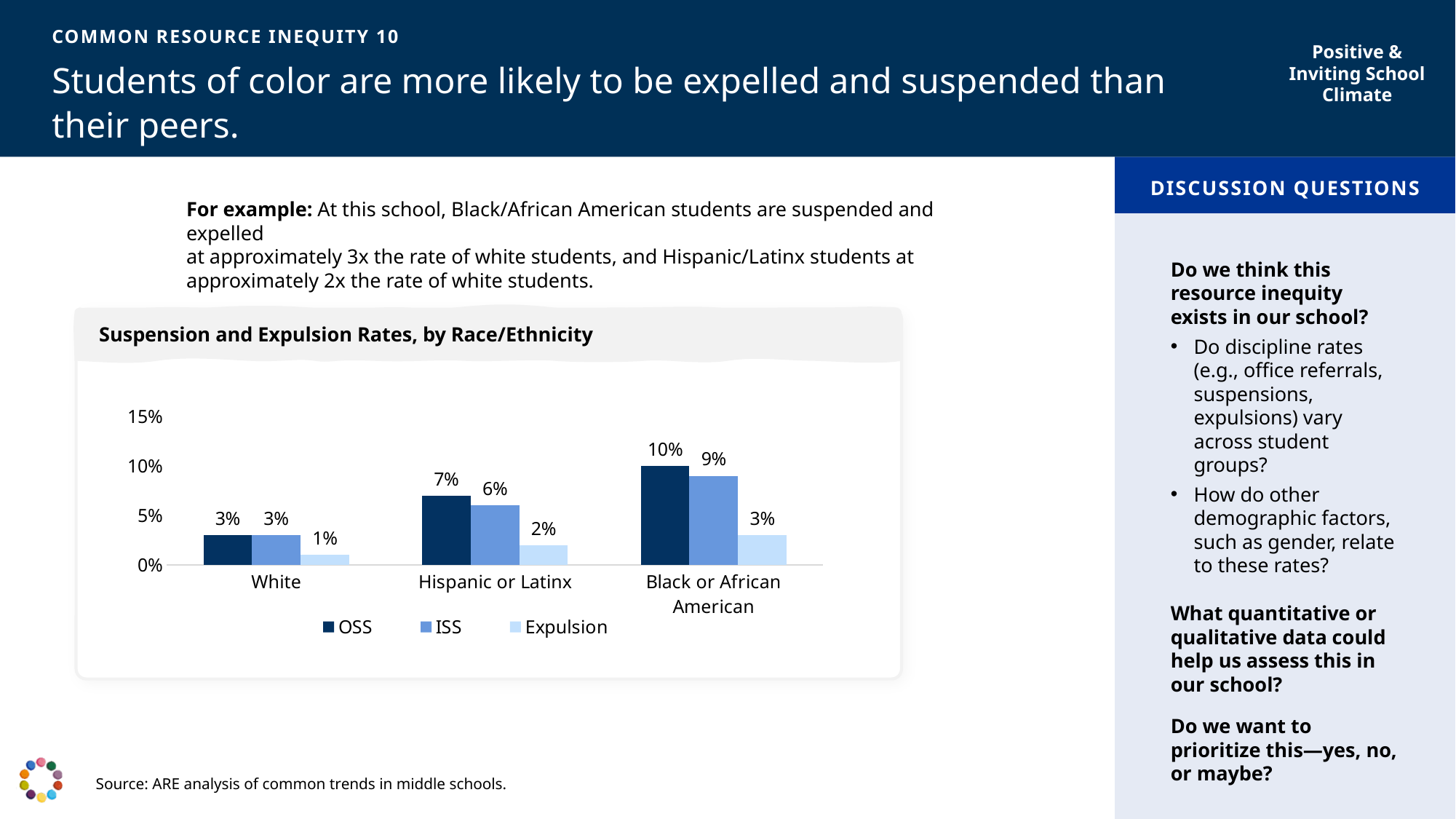
Do the OSS rates rise or fall moving from White to Black or African American along the x axis? Rise What is the OSS rate for Black or African American students? 10% How many series does the legend list? 3 How many race/ethnicity categories are shown on the x axis? 3 Which race/ethnicity group has the lowest Expulsion rate? White What is the Expulsion rate for White students? 1% What is the ISS rate for Hispanic or Latinx students? 6% What kind of chart is shown on the slide? Bar chart Which race/ethnicity group has the highest OSS rate? Black or African American What is the difference between the OSS rate for Black or African American students and the OSS rate for White students? 7% What is the title of the chart? Suspension and Expulsion Rates, by Race/Ethnicity Which is larger: the ISS rate for Hispanic or Latinx students or the ISS rate for Black or African American students? Black or African American